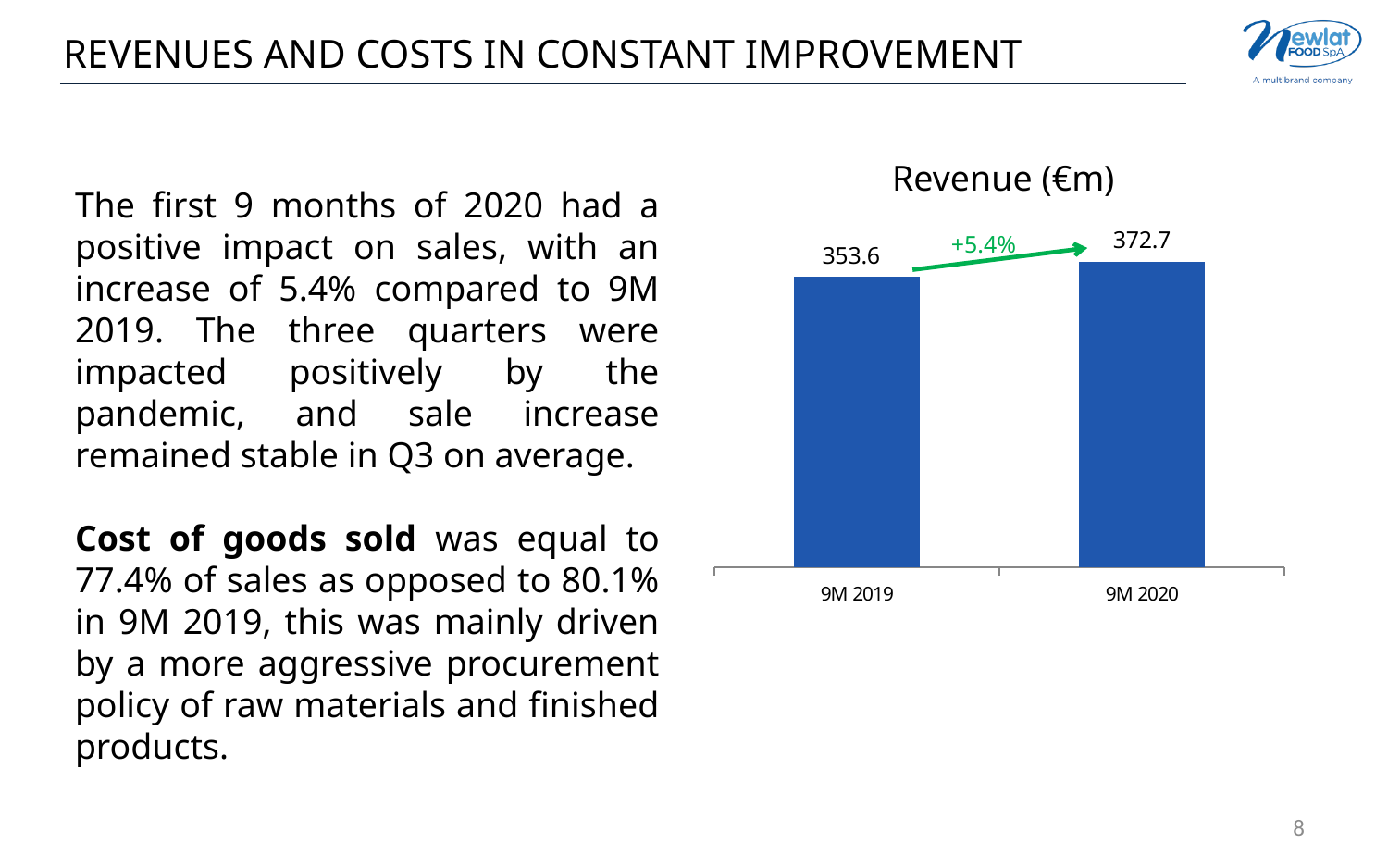
Is the revenue for 9M 2020 larger or smaller than the revenue for 9M 2019? larger What is the revenue value for 9M 2020? 372.7 Which period has the lower revenue? 9M 2019 What is the difference in revenue between 9M 2020 and 9M 2019? 19.1 What percentage change is shown by the arrow between the two bars? +5.4% How many periods are shown in the chart? 2 What is the title of the chart? Revenue (€m) What type of chart is used to show revenue? bar chart What is the revenue value for 9M 2019? 353.6 Does revenue rise or fall from 9M 2019 to 9M 2020? rise Which period has the higher revenue? 9M 2020